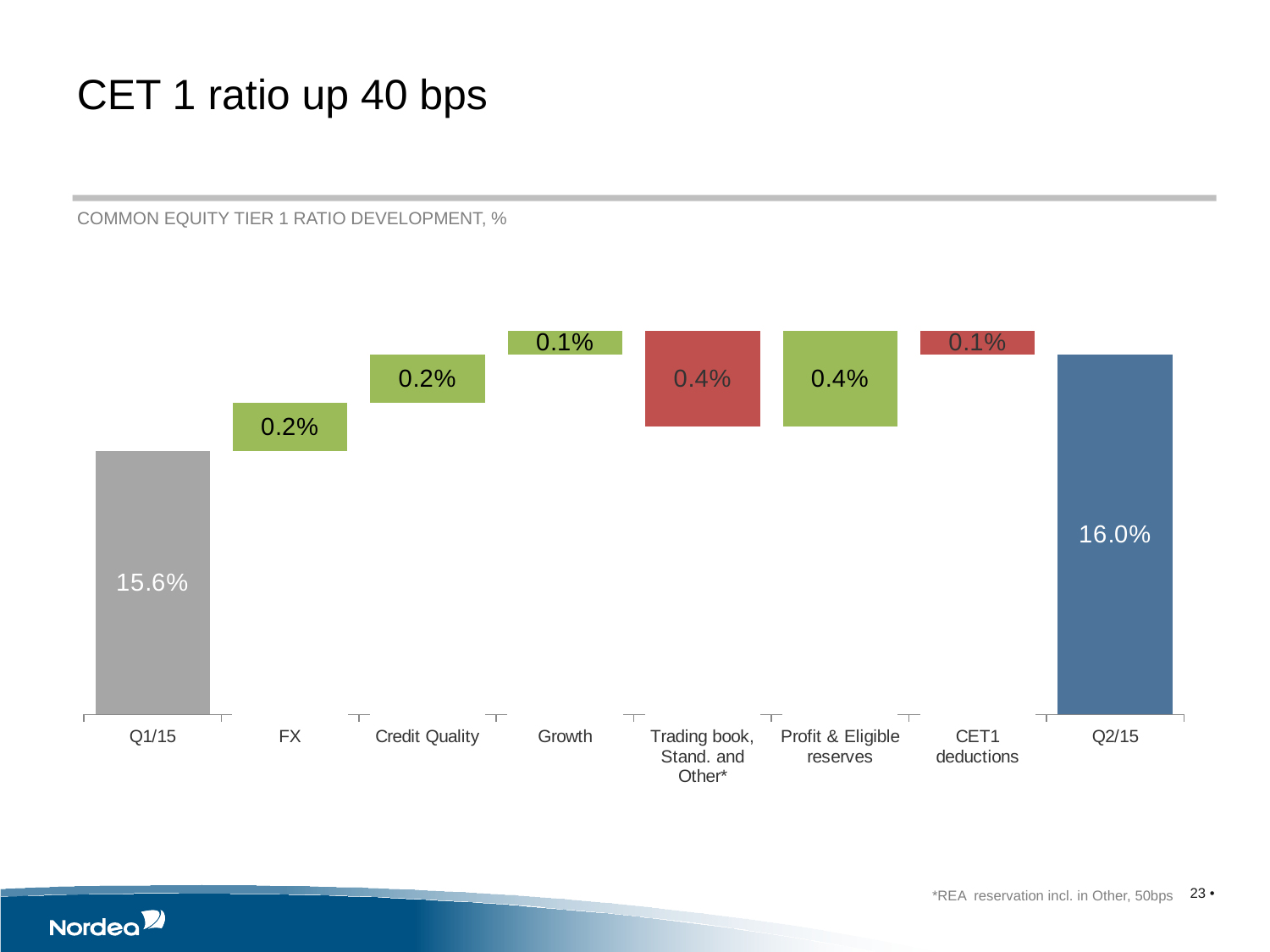
What kind of chart is shown on the slide? Waterfall bar chart What value is shown for the FX bar? 0.2% What is the CET 1 ratio shown for Q1/15? 15.6% What value is shown for the Profit & Eligible reserves bar? 0.4% What is the subtitle printed above the chart? COMMON EQUITY TIER 1 RATIO DEVELOPMENT, % What value is shown for the CET1 deductions bar? 0.1% What is the difference between the Q2/15 and Q1/15 CET 1 ratios? 0.4% What value is shown for the Credit Quality bar? 0.2% Which is larger, the Q1/15 ratio or the Q2/15 ratio? Q2/15 What is the CET 1 ratio shown for Q2/15? 16.0% What value is shown for the Growth bar? 0.1% How many categories are shown on the x axis of the chart? 8